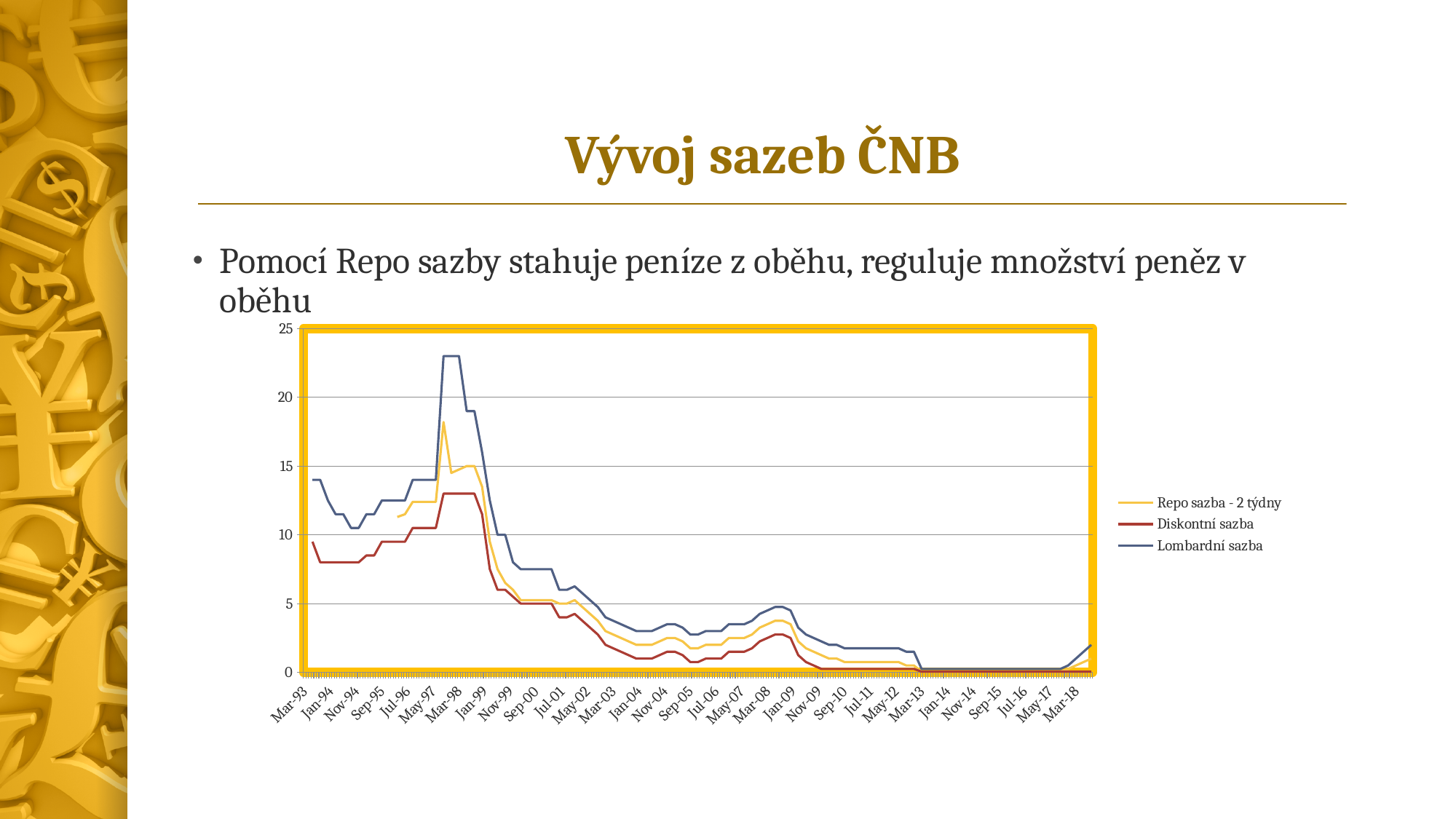
Do the rates generally rise or fall between Mar-98 and Mar-13? fall Is the peak value of Repo sazba - 2 týdny greater or less than 15? greater Around Mar-98, which is larger: Lombardní sazba or Diskontní sazba? Lombardní sazba Which series has the lowest values around Sep-10? Diskontní sazba Is the peak value of Lombardní sazba greater or less than 20? greater How many series does the chart legend list? 3 Which series is drawn in red in the chart? Diskontní sazba Which series reaches the highest value on the chart? Lombardní sazba What kind of chart is shown on the slide? line chart What is the title of the slide containing the chart? Vývoj sazeb ČNB Is the peak value of Diskontní sazba greater or less than 15? less